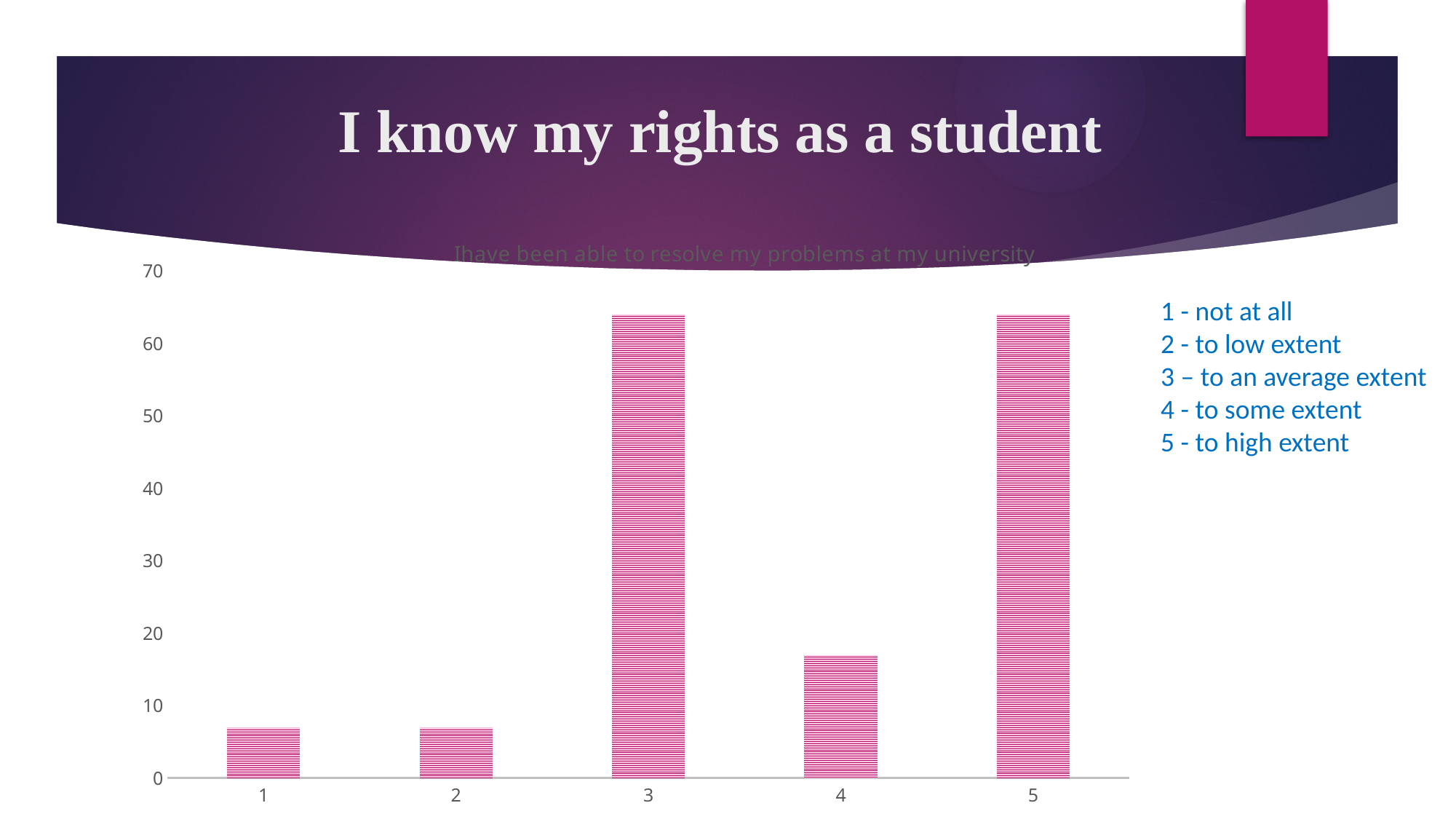
Is the value for category 2 greater or less than 10? less Is the value for category 1 greater or less than 10? less Is the value for category 4 greater or less than 10? greater Which has the larger value, category 3 or category 4? 3 According to the key on the slide, what does a rating of 5 mean? to high extent What is the highest value shown on the y axis of the chart? 70 What kind of chart is shown on the slide? bar chart Which has the larger value, category 1 or category 4? 4 How many categories are plotted on the x axis of the chart? 5